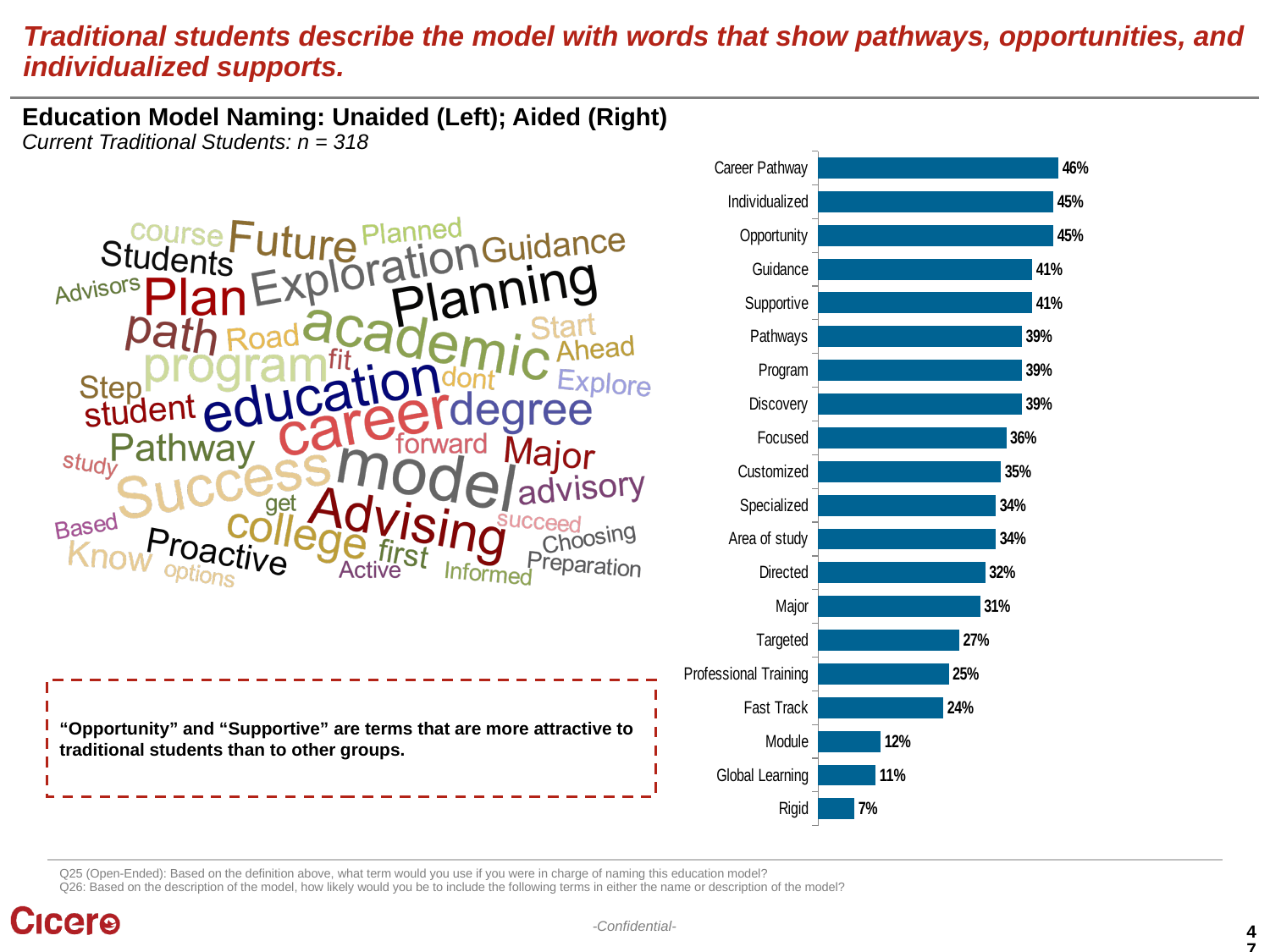
In the bar chart on the right, which term has the highest value? Career Pathway In the bar chart on the right, what is the value for Global Learning? 11% What is the sample size (n) stated under the chart title? 318 In the bar chart on the right, which term has the lowest value? Rigid In the bar chart on the right, which has a larger value, Targeted or Directed? Directed How many terms are listed in the bar chart on the right? 20 In the bar chart on the right, what is the difference between the values for Focused and Module? 24% In the bar chart on the right, what is the value for Guidance? 41% What kind of chart is shown on the right side of the slide? Bar chart In the bar chart on the right, what is the value for Fast Track? 24% In the bar chart on the right, what is the difference between the values for Career Pathway and Rigid? 39% In the bar chart on the right, what is the value for Career Pathway? 46%